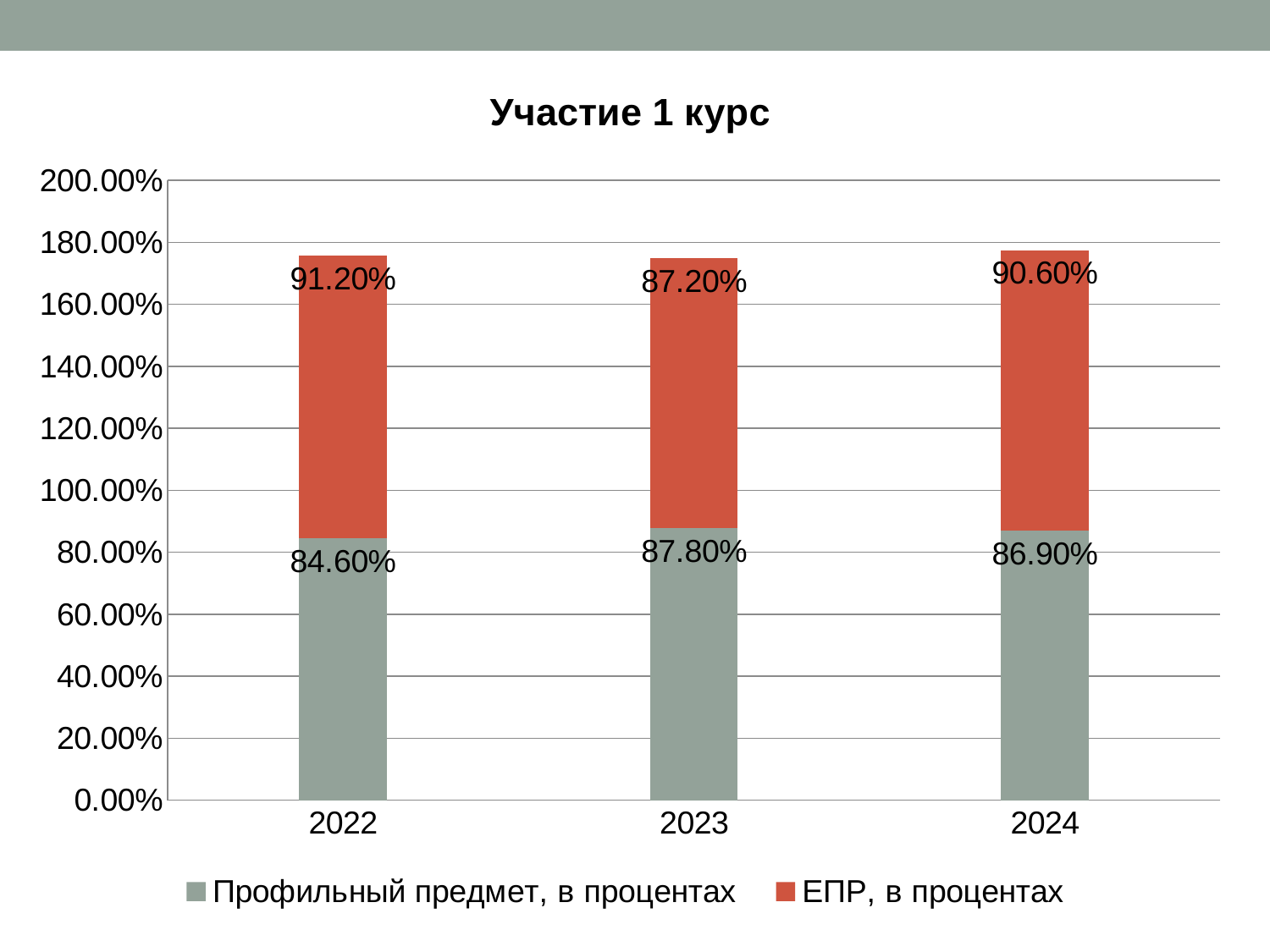
Which year has the lowest value for ЕПР, в процентах? 2023 What is the difference between the ЕПР, в процентах values for 2022 and 2023? 4.00% Which is larger in 2024: Профильный предмет, в процентах or ЕПР, в процентах? ЕПР, в процентах What is the value for ЕПР, в процентах in 2024? 90.60% How many years are shown on the x axis? 3 How many series does the legend list? 2 What is the total of the stacked bar for 2024? 177.50% What kind of chart is shown? Stacked bar chart What is the value for Профильный предмет, в процентах in 2023? 87.80% What is the title of the chart? Участие 1 курс What is the value for ЕПР, в процентах in 2022? 91.20% Which year has the highest value for Профильный предмет, в процентах? 2023